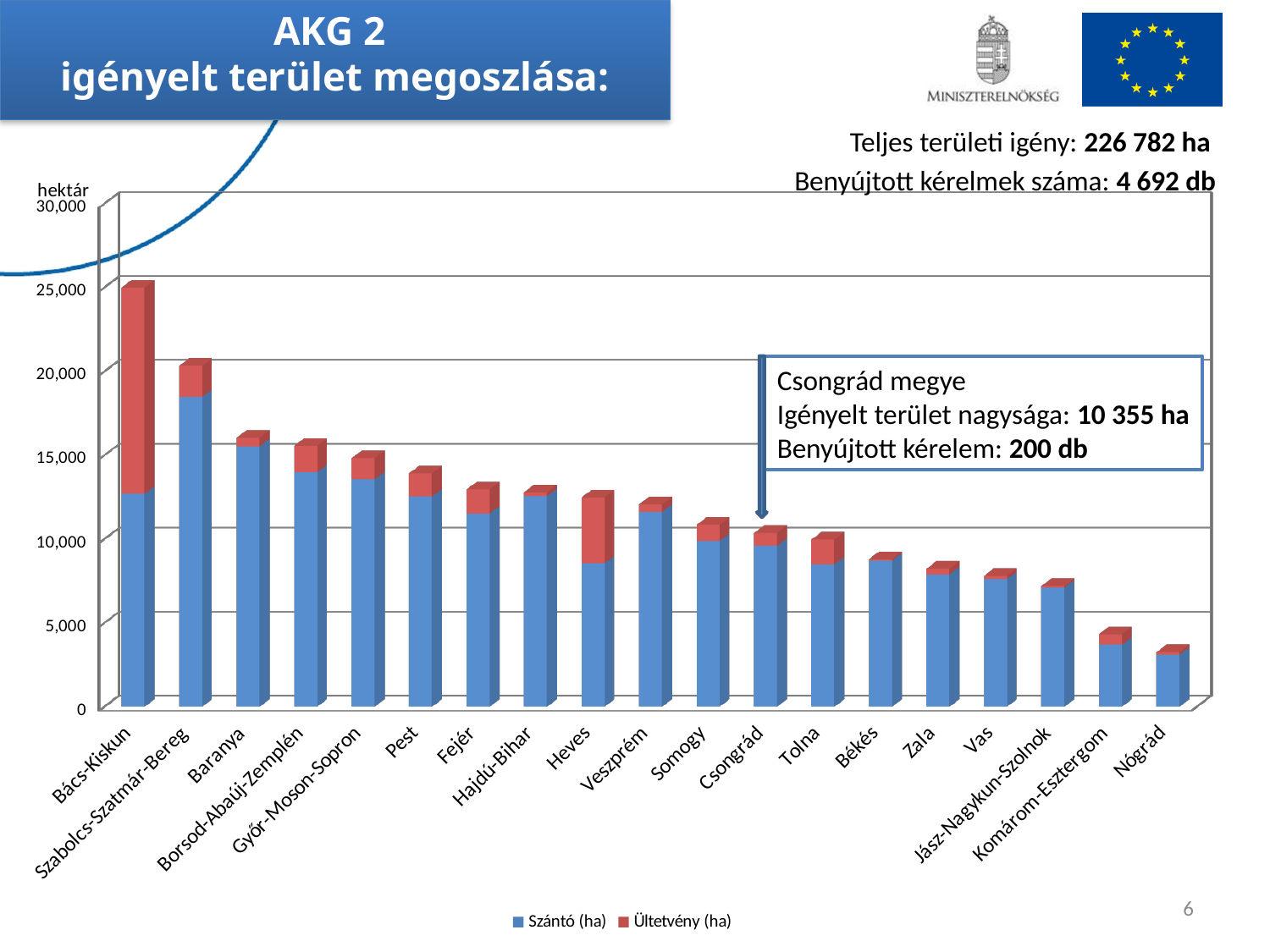
How many series does the legend list? 2 Is the total value for Bács-Kiskun greater or less than 20,000? greater Which county has the lowest total bar? Nógrád What kind of chart is shown on the slide? bar chart What are the two series named in the legend? Szántó (ha) and Ültetvény (ha) According to the callout, what is the requested area (igényelt terület) for Csongrád county? 10 355 ha Which county has the highest total bar? Bács-Kiskun Is the total value for Nógrád greater or less than 5,000? less How many counties (categories) are shown on the x axis? 19 Which has a larger total bar, Heves or Zala? Heves Is the total value for Békés greater or less than 10,000? less Do the total bar heights rise or fall moving from left to right along the x axis? fall